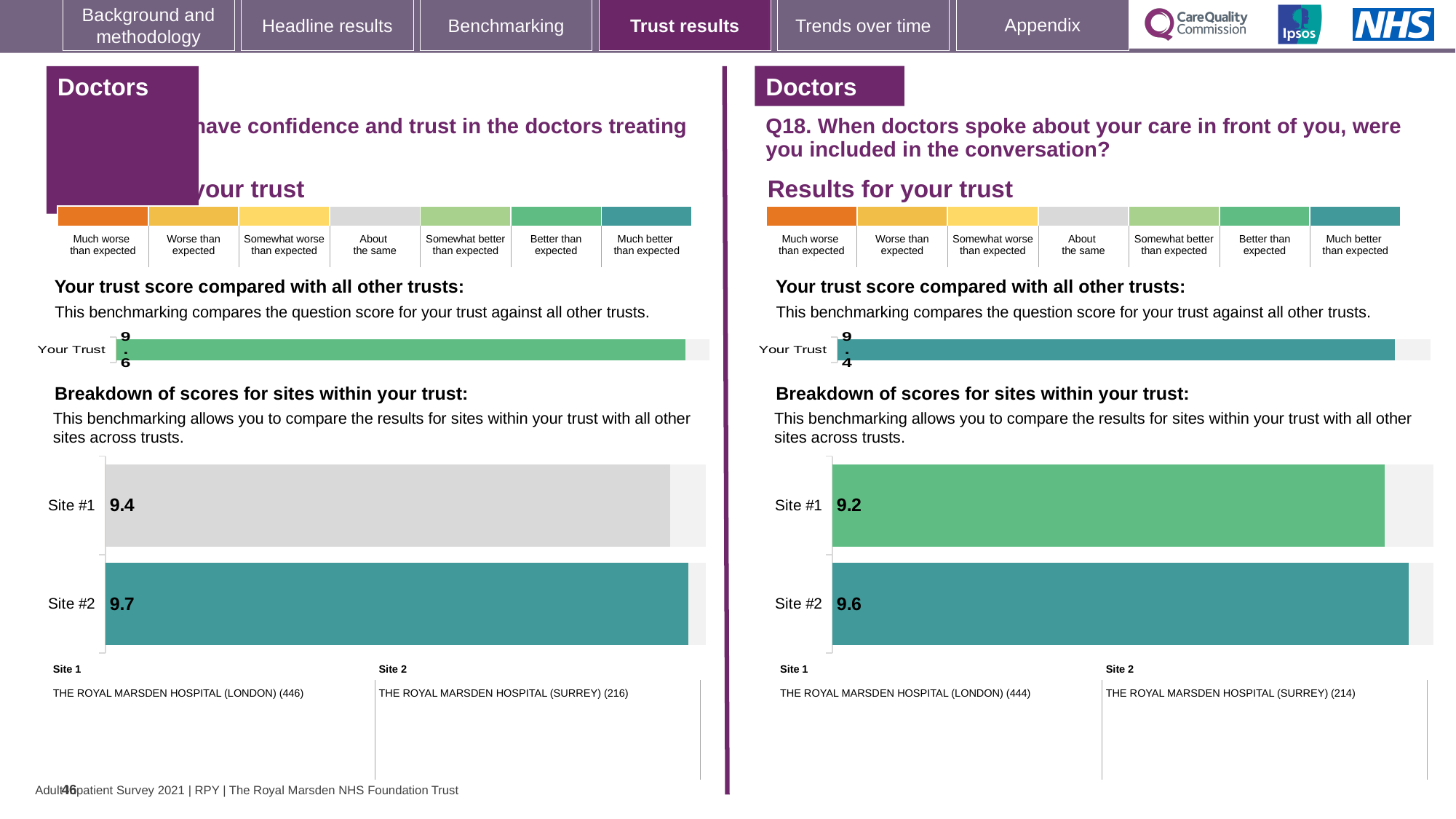
In the right-hand (Q18) site breakdown chart, what is the difference between the Site #2 and Site #1 scores? 0.4 In the right-hand (Q18) 'Breakdown of scores for sites within your trust' chart, what is the score for Site #1? 9.2 On the left-hand side of the slide, what is the 'Your Trust' score shown in the trust comparison bar chart? 9.6 In the left-hand 'Breakdown of scores for sites within your trust' chart, what is the score for Site #1? 9.4 In the right-hand (Q18) site breakdown chart, which site has the lower score? Site #1 In the left-hand site breakdown chart, which site has the higher score? Site #2 In the left-hand site breakdown chart, what is the difference between the Site #2 and Site #1 scores? 0.3 In the left-hand 'Breakdown of scores for sites within your trust' chart, what is the score for Site #2? 9.7 What type of chart is used for the site breakdown on the left-hand side of the slide? Bar chart In the right-hand (Q18) 'Breakdown of scores for sites within your trust' chart, what is the score for Site #2? 9.6 How many sites are shown in the right-hand (Q18) site breakdown chart? 2 On the right-hand side of the slide (Q18), what is the 'Your Trust' score shown in the trust comparison bar chart? 9.4